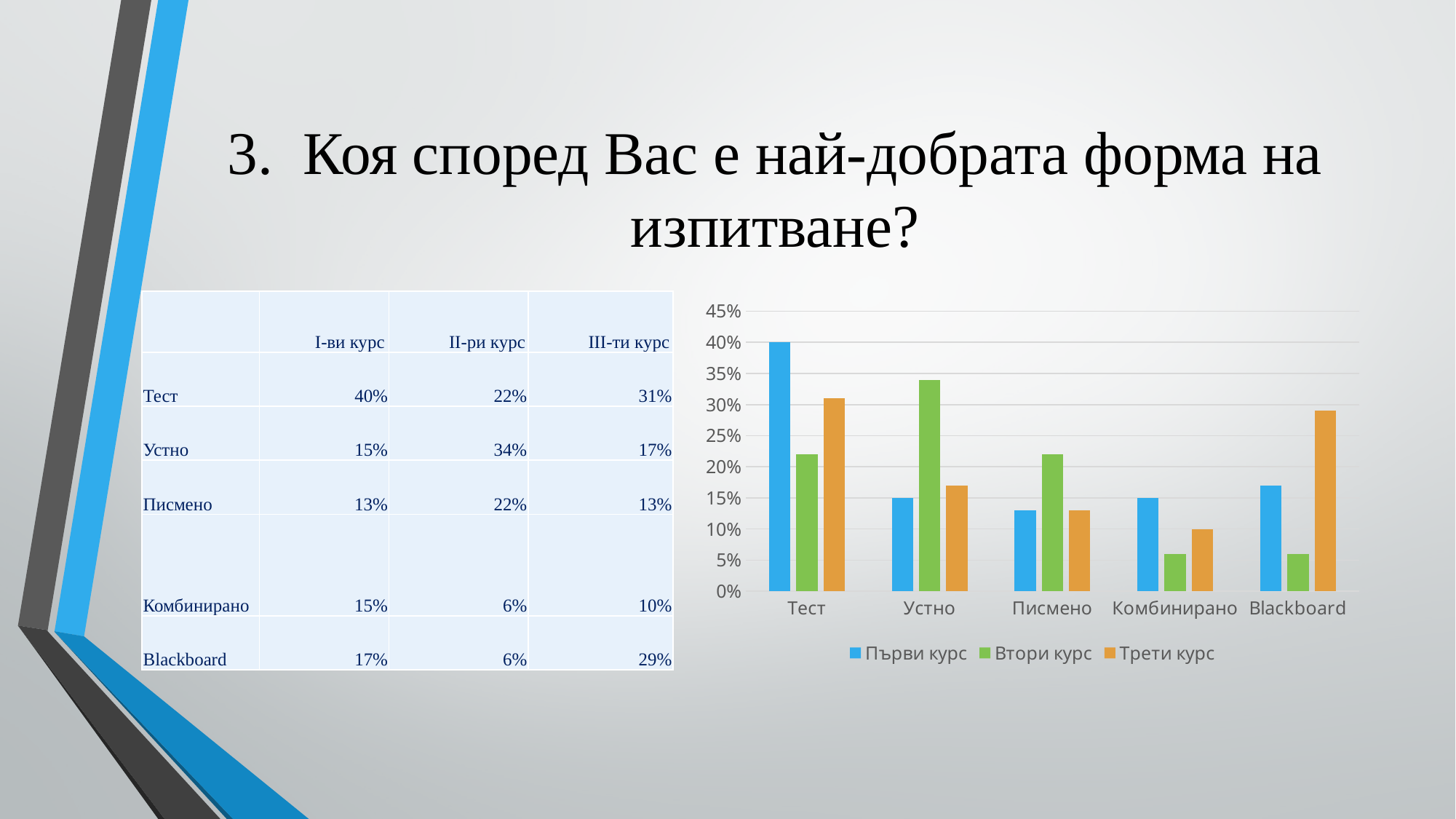
In the Blackboard category, which is larger: Първи курс or Трети курс? Трети курс What kind of chart is shown on the slide? bar chart Is the value for Втори курс in the Писмено category greater or less than 20%? greater How many series does the chart legend list? 3 What is the value for Първи курс in the Тест category? 40% What is the value for Трети курс in the Blackboard category? 29% Which category has the highest value for Първи курс? Тест How many categories are shown on the x axis of the chart? 5 What colour are the bars for Трети курс in the chart? orange What is the difference between Първи курс and Втори курс in the Тест category? 18% What is the value for Втори курс in the Устно category? 34% Which category has the lowest value for Трети курс? Комбинирано